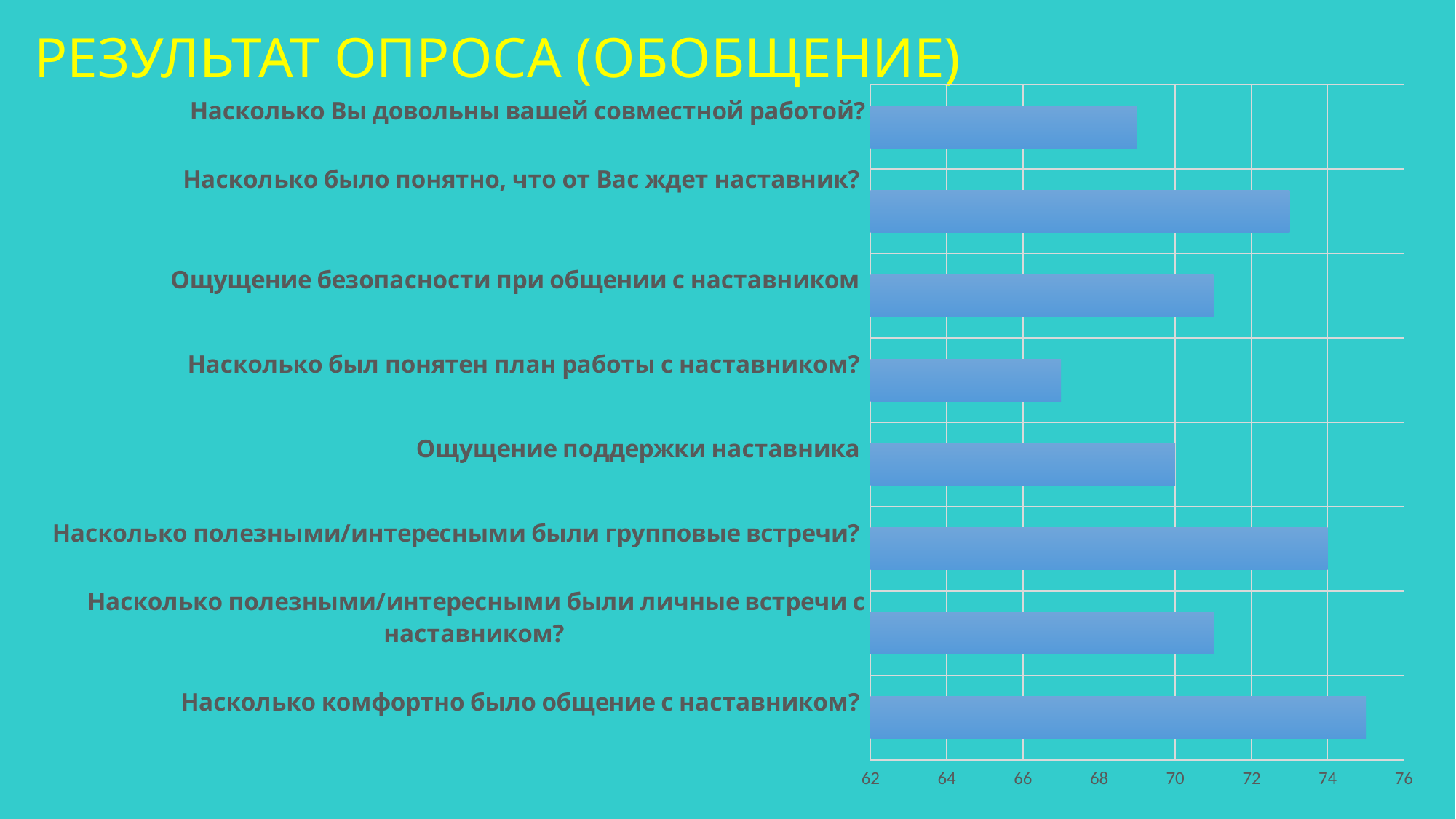
Which category has the highest value? Насколько комфортно было общение с наставником? What is the title of the slide containing the chart? РЕЗУЛЬТАТ ОПРОСА (ОБОБЩЕНИЕ) Which category has the lowest value? Насколько был понятен план работы с наставником? Is the value for "Насколько комфортно было общение с наставником?" greater or less than 74? greater What is the value for "Ощущение поддержки наставника"? 70 Is the value for "Насколько было понятно, что от Вас ждет наставник?" greater or less than 72? greater What kind of chart is shown on the slide? Bar chart Which is larger: the value for "Насколько полезными/интересными были групповые встречи?" or the value for "Ощущение поддержки наставника"? Насколько полезными/интересными были групповые встречи? Is the value for "Насколько был понятен план работы с наставником?" greater or less than 68? less What is the value for "Насколько полезными/интересными были групповые встречи?"? 74 How many categories (survey questions) are plotted in the chart? 8